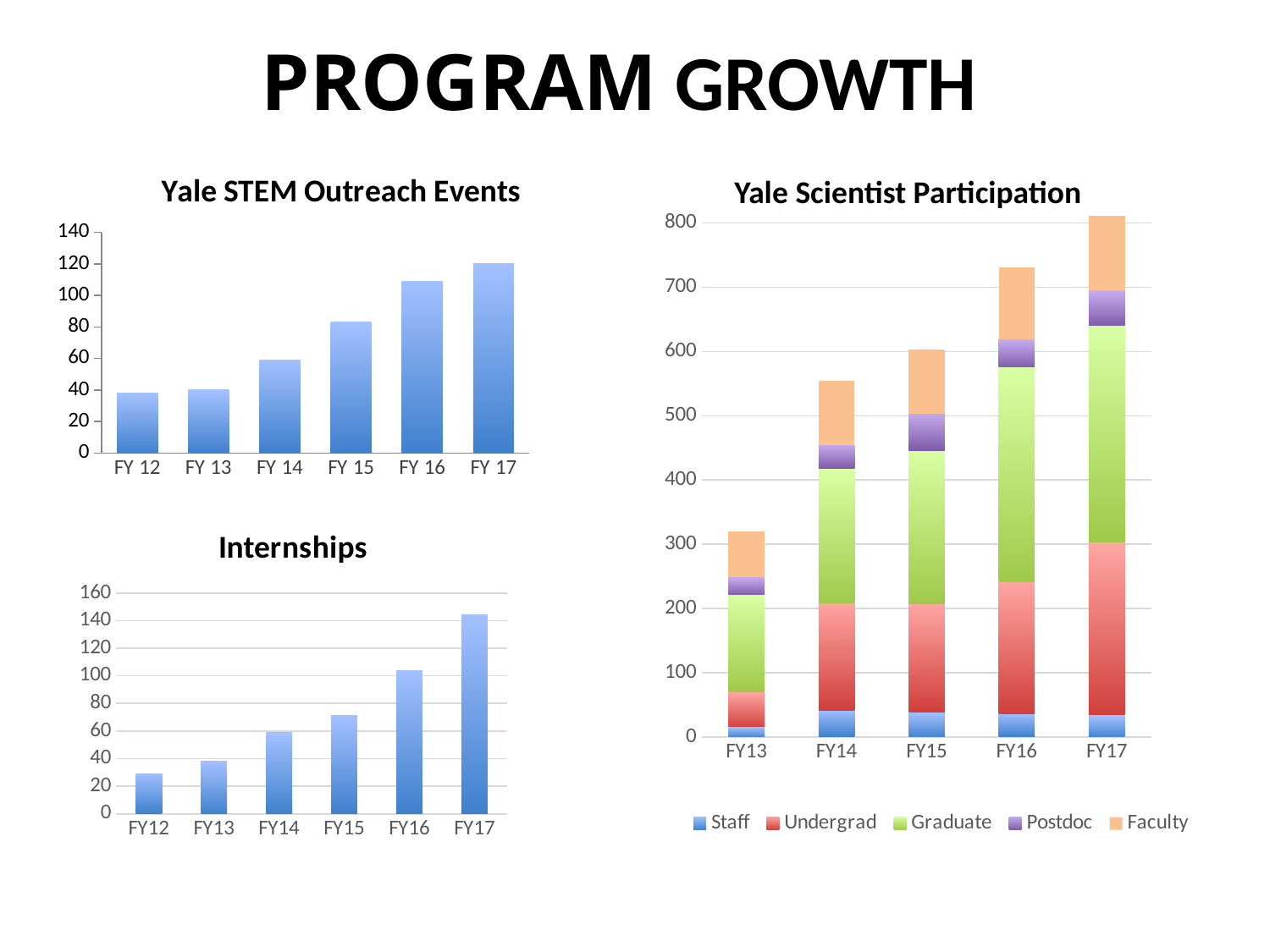
In the "Yale STEM Outreach Events" chart, is the value for FY 16 greater or less than 100? greater In the "Yale STEM Outreach Events" chart, do the values rise or fall from FY 12 to FY 17? rise In the "Internships" chart, is the value for FY15 greater or less than 80? less In the "Internships" chart, which fiscal year has the lowest value? FY12 In the "Internships" chart, is the value for FY17 greater or less than 120? greater How many series does the legend of the "Yale Scientist Participation" chart list? 5 In the "Yale STEM Outreach Events" chart, which fiscal year has the highest value? FY 17 How many fiscal years are shown in the "Internships" chart? 6 In the "Yale Scientist Participation" chart, which fiscal year has the tallest stacked bar? FY17 What kind of chart is the "Yale STEM Outreach Events" chart? bar chart